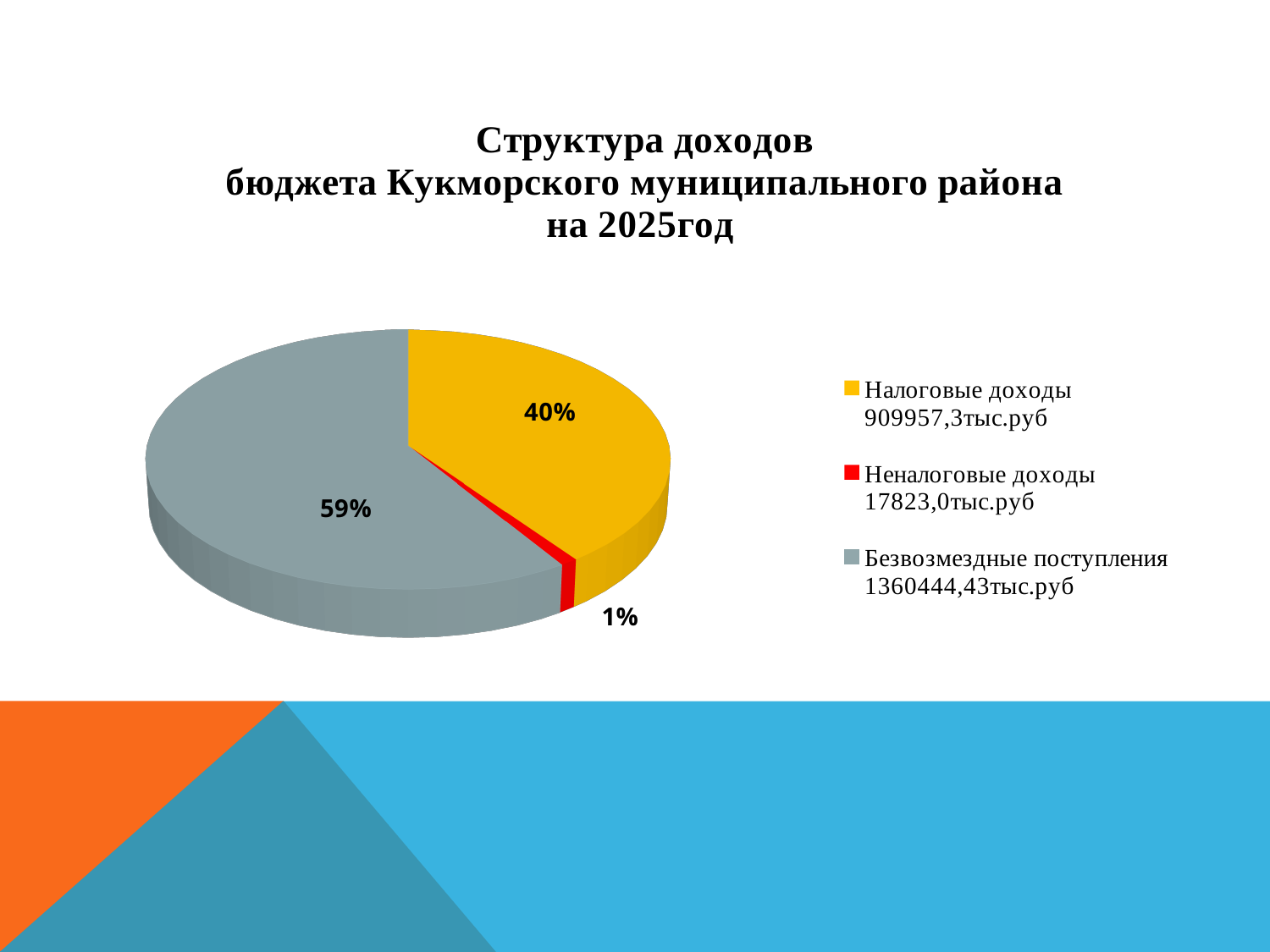
What kind of chart is shown on the slide? Pie chart What share of the pie does Безвозмездные поступления take? 59% What share of the pie does Неналоговые доходы take? 1% Which category has the smallest slice of the pie? Неналоговые доходы Which category has the largest slice of the pie? Безвозмездные поступления What amount does the legend give for Безвозмездные поступления? 1360444,43тыс.руб How many entries does the legend list? 3 How many slices does the pie chart have? 3 What share of the pie does Налоговые доходы take? 40% What is the difference in percentage points between the Безвозмездные поступления slice and the Налоговые доходы slice? 19 percentage points Which slice is larger, Налоговые доходы or Неналоговые доходы? Налоговые доходы What colour is the Неналоговые доходы slice? Red